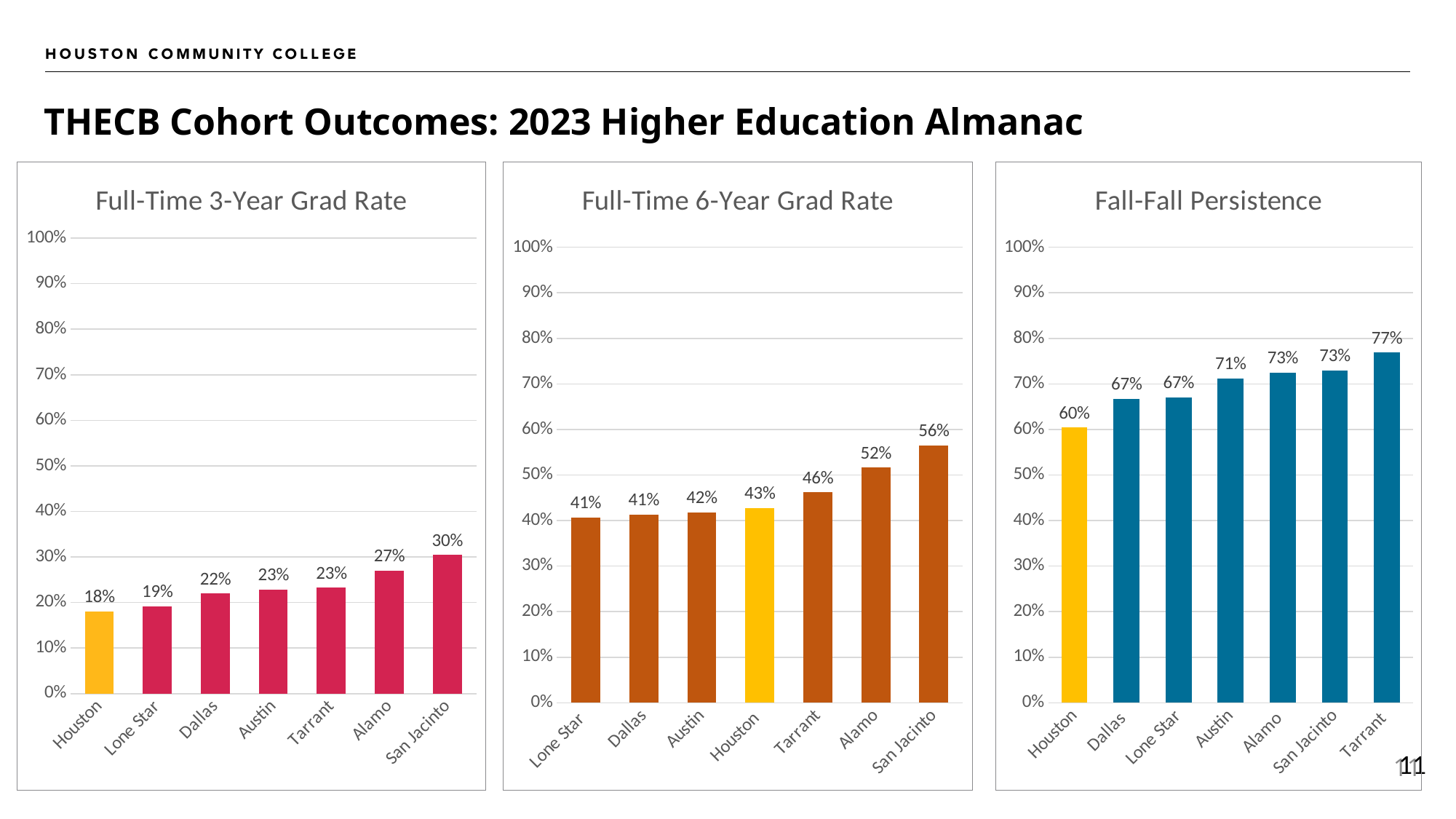
In the Fall-Fall Persistence chart, which college has the highest value? Tarrant What kind of chart is the Full-Time 3-Year Grad Rate chart? Bar chart In the Full-Time 6-Year Grad Rate chart, do the values rise or fall from left to right? Rise In the Full-Time 3-Year Grad Rate chart, which college has the highest value? San Jacinto In the Full-Time 6-Year Grad Rate chart, which college has the lowest value? Lone Star and Dallas (both 41%) In the Full-Time 3-Year Grad Rate chart, what is the value for Houston? 18% In the Fall-Fall Persistence chart, what is the value for Austin? 71% In the Full-Time 6-Year Grad Rate chart, what is the value for Tarrant? 46% In the Full-Time 3-Year Grad Rate chart, what is the difference between San Jacinto and Houston? 12% In the Full-Time 6-Year Grad Rate chart, which is larger, Alamo or Houston? Alamo How many colleges are shown in the Fall-Fall Persistence chart? 7 In the Fall-Fall Persistence chart, what is the difference between Tarrant and Houston? 17%